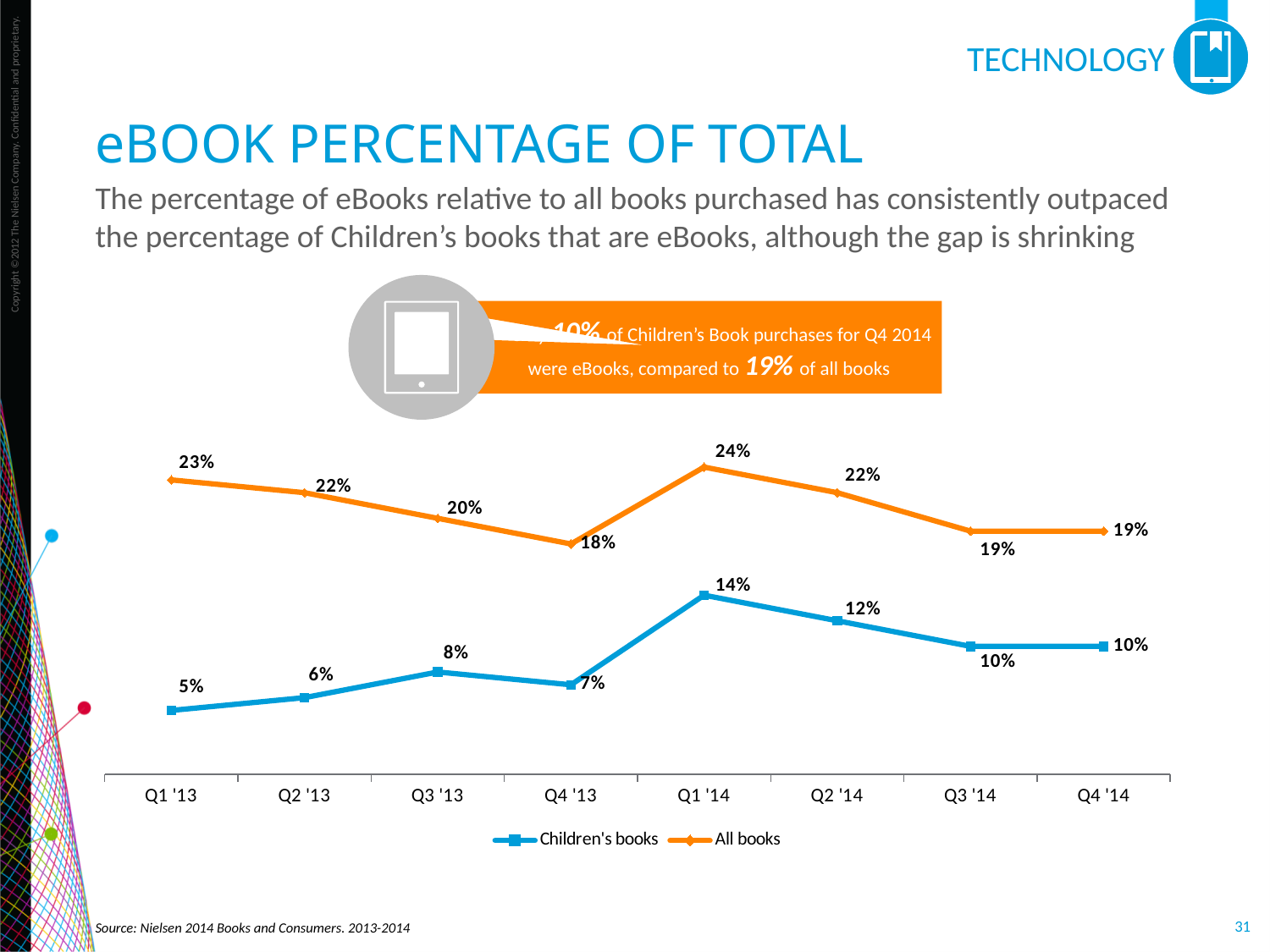
Which series has the higher value in Q2 '14, Children's books or All books? All books Does the Children's books series rise or fall from Q1 '13 to Q3 '13? Rise What is the value for All books in Q1 '14? 24% How many quarters are plotted on the x axis? 8 How many series does the legend list? 2 In which quarter is the Children's books series at its highest? Q1 '14 What type of chart is shown on the slide? Line chart What is the value for Children's books in Q1 '13? 5% What is the difference between All books and Children's books in Q4 '14? 9% What is the value for Children's books in Q4 '14? 10% What is the difference between All books and Children's books in Q1 '13? 18% In which quarter is the All books series at its lowest? Q4 '13